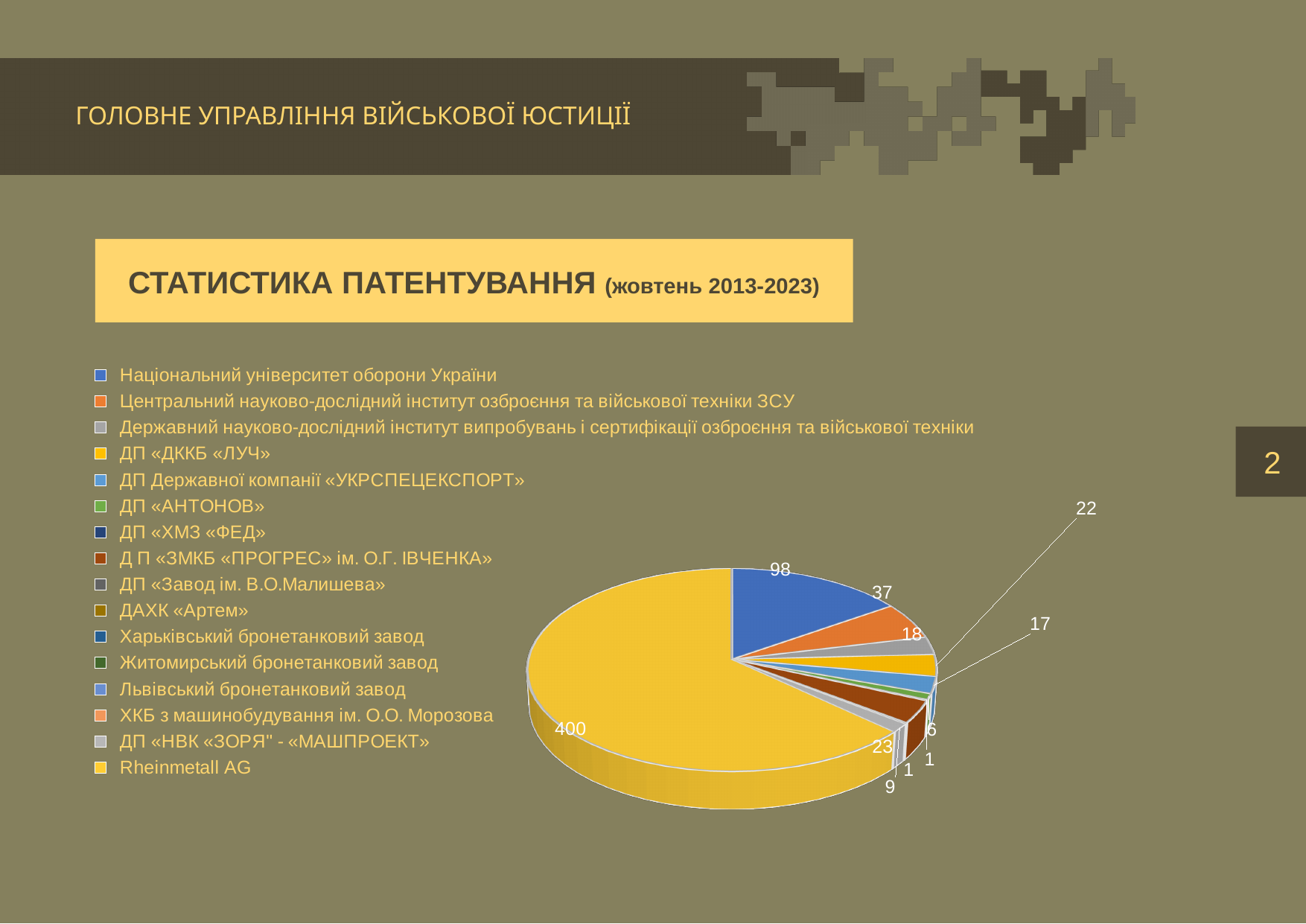
What is the difference between the values for ДП «ДККБ «ЛУЧ» and Державний науково-дослідний інститут випробувань і сертифікації озброєння та військової техніки? 4 What is the value for Центральний науково-дослідний інститут озброєння та військової техніки ЗСУ? 37 What period does the chart title say the statistics cover? жовтень 2013-2023 What is the value for Національний університет оборони України? 98 What is the title of the chart on the slide? СТАТИСТИКА ПАТЕНТУВАННЯ (жовтень 2013-2023) What is the value of the largest slice in the pie chart? 400 Which has a larger value: Національний університет оборони України or Центральний науково-дослідний інститут озброєння та військової техніки ЗСУ? Національний університет оборони України How many entries does the chart legend list? 16 What is the value for ДП Державної компанії «УКРСПЕЦЕКСПОРТ»? 17 What is the difference between the values for Національний університет оборони України and Центральний науково-дослідний інститут озброєння та військової техніки ЗСУ? 61 What is the value for ДП «ДККБ «ЛУЧ»? 22 What kind of chart is shown on the slide? pie chart